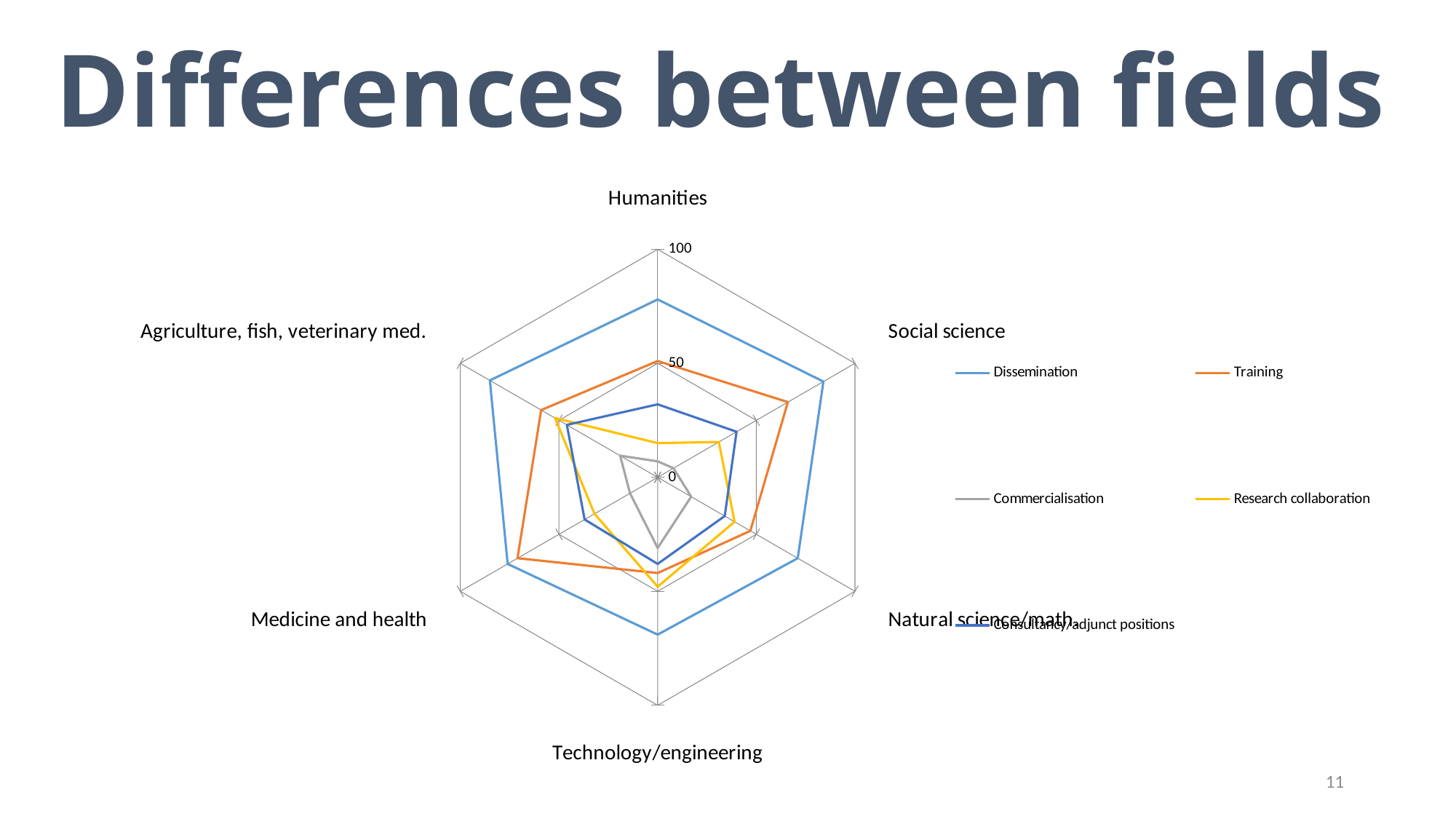
Is the Dissemination value for Humanities greater or less than 50? greater For Social science, which is larger: Training or Consultancy/adjunct positions? Training Is the Training value for Medicine and health greater or less than 50? greater Which series has the highest values across all fields? Dissemination Is the Consultancy/adjunct positions value for Humanities greater or less than 50? less How many fields (categories) are plotted on the radar chart? 6 For which field is the Commercialisation value highest? Technology/engineering What is the title of the slide? Differences between fields How many series does the legend list? 5 Which series has the lowest values across all fields? Commercialisation What kind of chart is shown on the slide? Radar chart